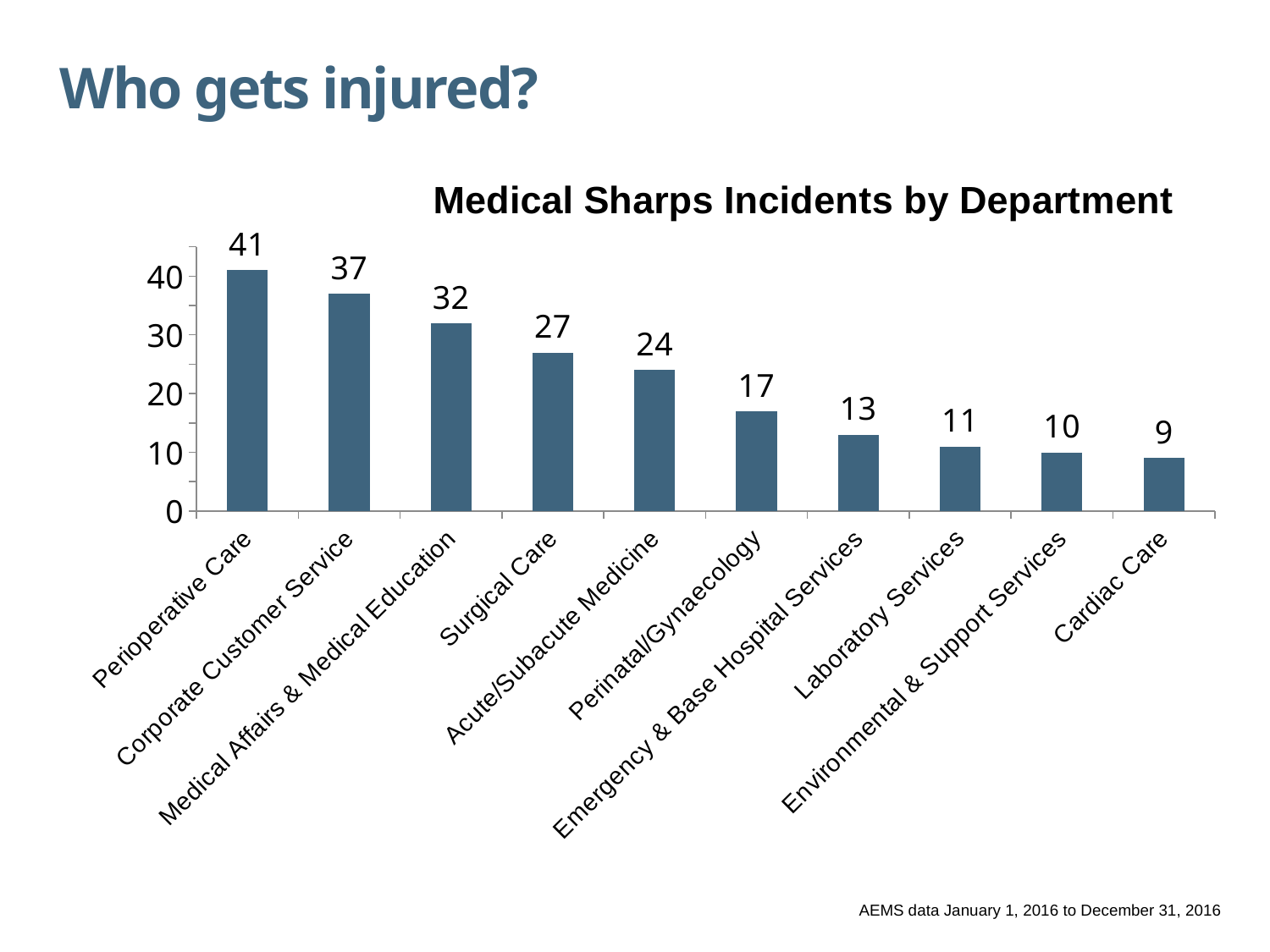
Which department has the lowest number of medical sharps incidents? Cardiac Care Which department has the highest number of medical sharps incidents? Perioperative Care Is the value for Surgical Care greater or less than 20? greater What is the value for Acute/Subacute Medicine? 24 Which is larger, the value for Emergency & Base Hospital Services or the value for Environmental & Support Services? Emergency & Base Hospital Services What is the value for Laboratory Services? 11 What is the title of the chart? Medical Sharps Incidents by Department What is the difference between the values for Corporate Customer Service and Surgical Care? 10 What is the difference between the values for Medical Affairs & Medical Education and Perinatal/Gynaecology? 15 What is the value for Perioperative Care? 41 What kind of chart is shown on the slide? bar chart How many departments are shown in the chart? 10